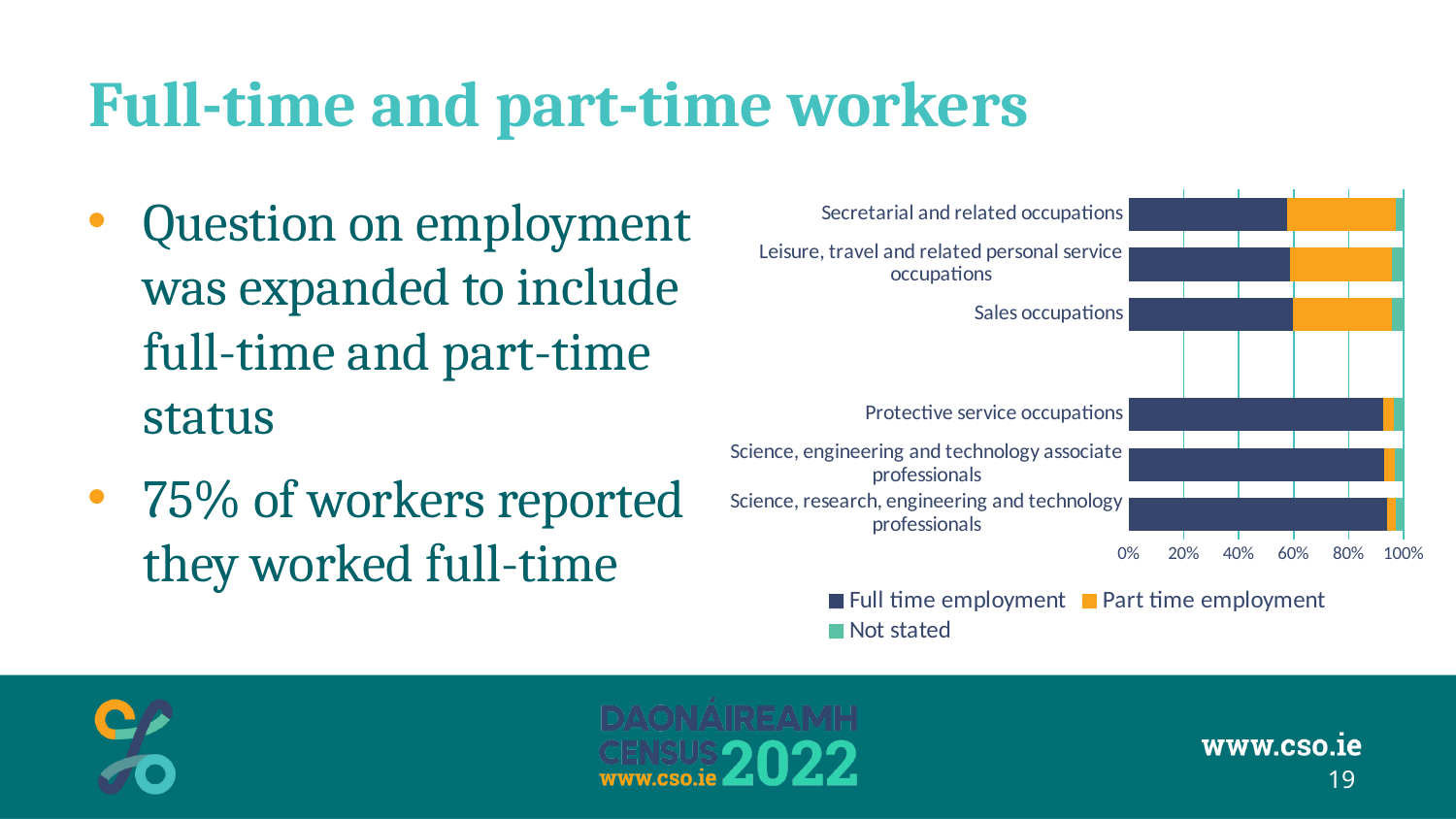
Is the Full time employment share for Leisure, travel and related personal service occupations greater or less than 40%? greater Is the Full time employment share for Science, research, engineering and technology professionals greater or less than 80%? greater What is the highest value shown on the chart's horizontal axis? 100% What kind of chart is shown on the slide? Bar chart Which has a larger Part time employment share: Secretarial and related occupations or Science, engineering and technology associate professionals? Secretarial and related occupations Which has a larger Full time employment share: Sales occupations or Protective service occupations? Protective service occupations Is the Full time employment share for Sales occupations greater or less than 80%? less Which series are listed in the chart legend? Full time employment, Part time employment, Not stated How many occupation categories are plotted in the chart? 6 How many series does the chart legend list? 3